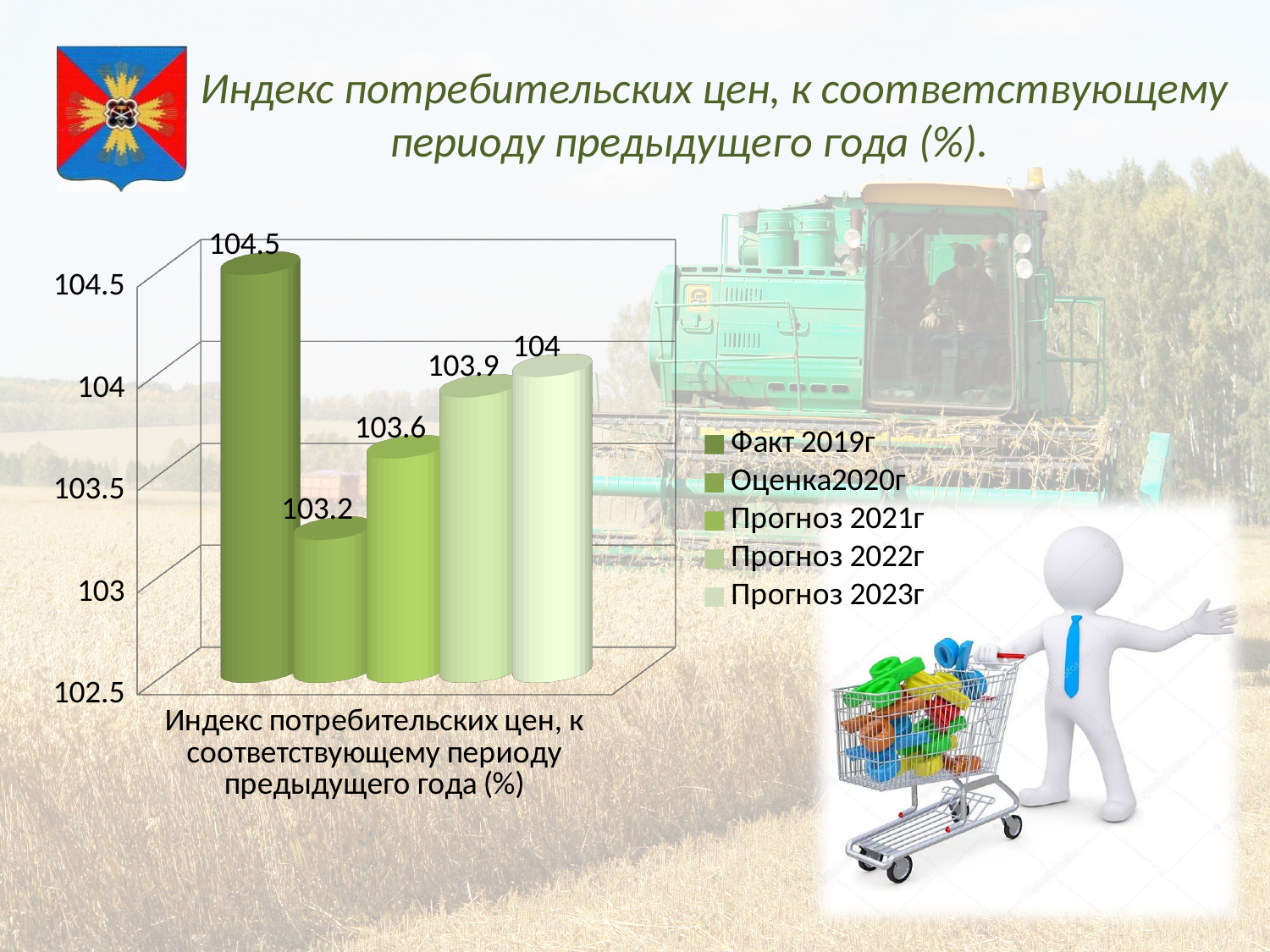
What kind of chart is shown on the slide? Bar chart What is the value for Прогноз 2021г? 103.6 Which series has the highest value? Факт 2019г Which is larger, the value for Прогноз 2021г or the value for Прогноз 2022г? Прогноз 2022г Do the values rise or fall from Оценка2020г through Прогноз 2023г? Rise What is the value for Факт 2019г? 104.5 What is the difference between the values for Факт 2019г and Оценка2020г? 1.3 What is the value for Оценка2020г? 103.2 What is the value for Прогноз 2022г? 103.9 Which series has the lowest value? Оценка2020г What is the value for Прогноз 2023г? 104 How many series does the legend list? 5